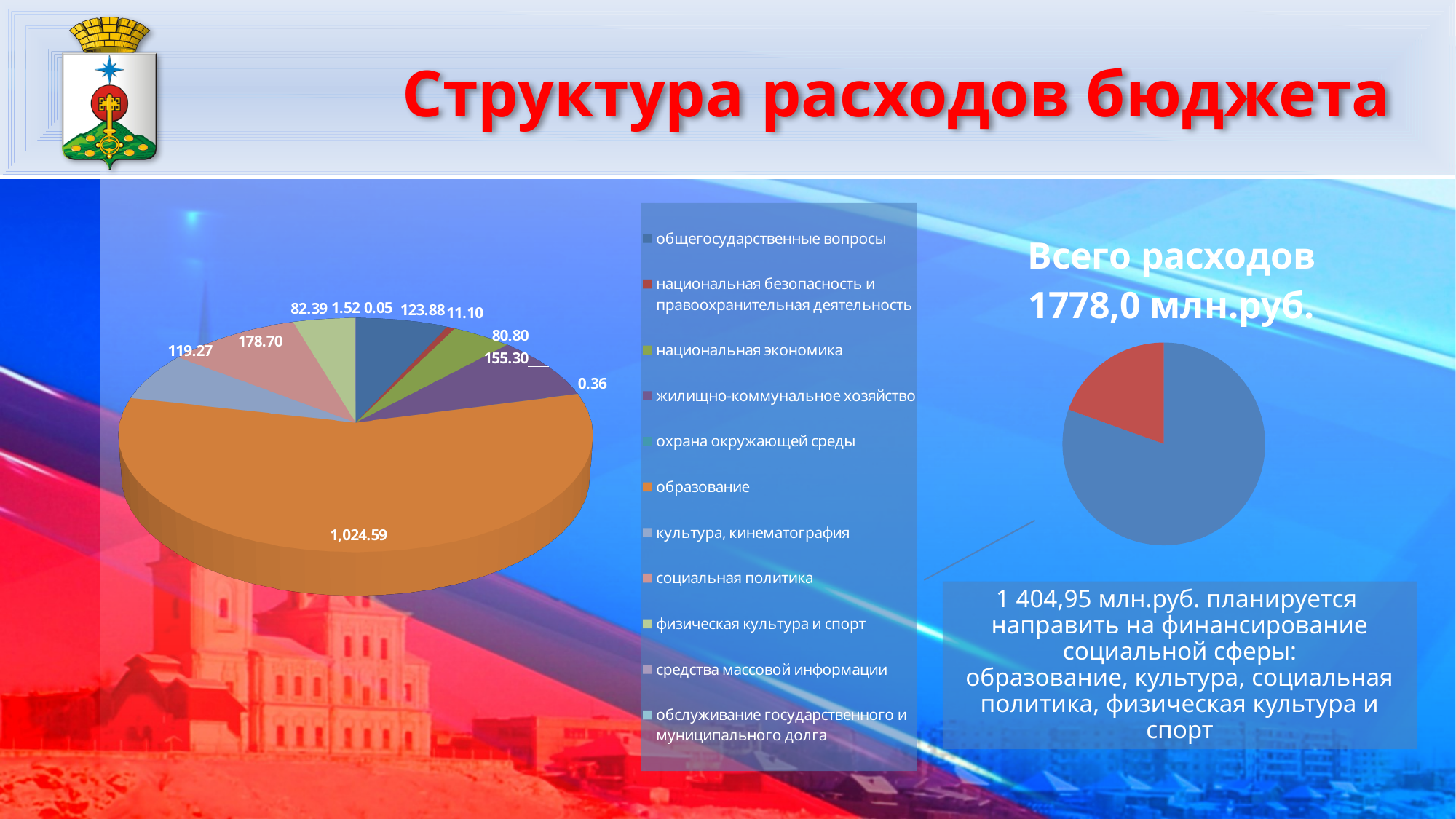
How many categories does the legend of the large pie chart list? 11 On the large pie chart, what is the value for жилищно-коммунальное хозяйство? 155.30 On the large pie chart, what is the value for образование? 1,024.59 On the large pie chart, what is the difference between the values for социальная политика and культура, кинематография? 59.43 On the large pie chart, which category has the largest value? образование On the large pie chart, which is larger: общегосударственные вопросы or национальная экономика? общегосударственные вопросы On the large pie chart, what colour is the slice for образование? orange On the large pie chart, what is the value for социальная политика? 178.70 What is the title of the slide containing the charts? Структура расходов бюджета What type of chart is the large chart on the left of the slide? pie chart On the large pie chart, which category has the smallest value? обслуживание государственного и муниципального долга On the large pie chart, what is the value for культура, кинематография? 119.27